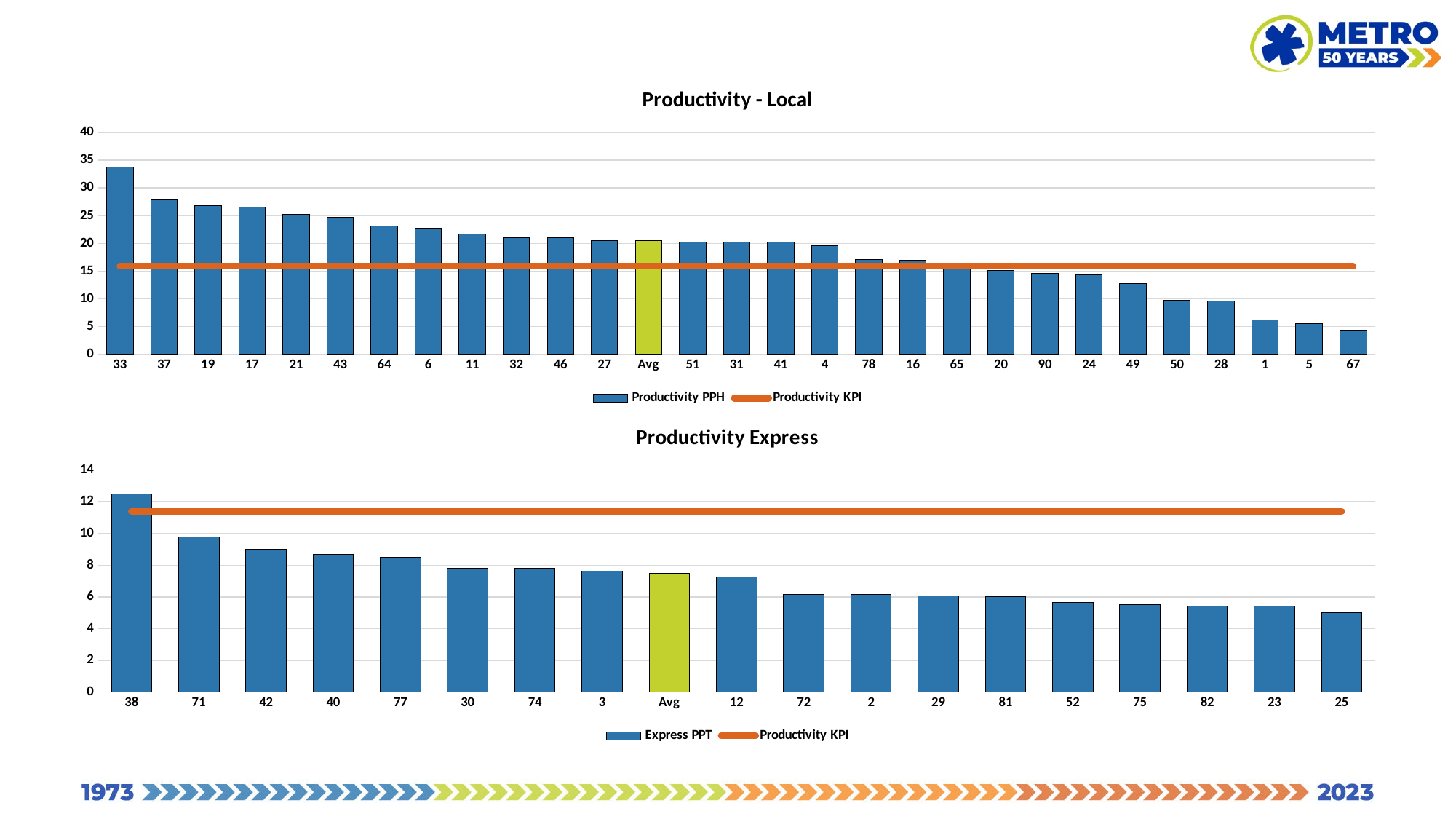
How many series does the legend of the Productivity - Local chart list? 2 In the Productivity - Local chart, which route has the highest Productivity PPH? 33 In the Productivity - Local chart, which is larger, the value for route 33 or route 37? 33 In the Productivity Express chart, which is larger, the value for route 71 or route 42? 71 In the Productivity Express chart, is the value for route 38 greater or less than 10? greater In the Productivity - Local chart, which route has the lowest Productivity PPH? 67 How many bars are plotted in the Productivity Express chart? 19 In the Productivity - Local chart, is the value for route 33 greater or less than 30? greater In the Productivity Express chart, which route has the highest Express PPT? 38 What kind of chart is the Productivity - Local chart? combination bar and line chart In the Productivity Express chart, do the bar values rise or fall from left to right? fall